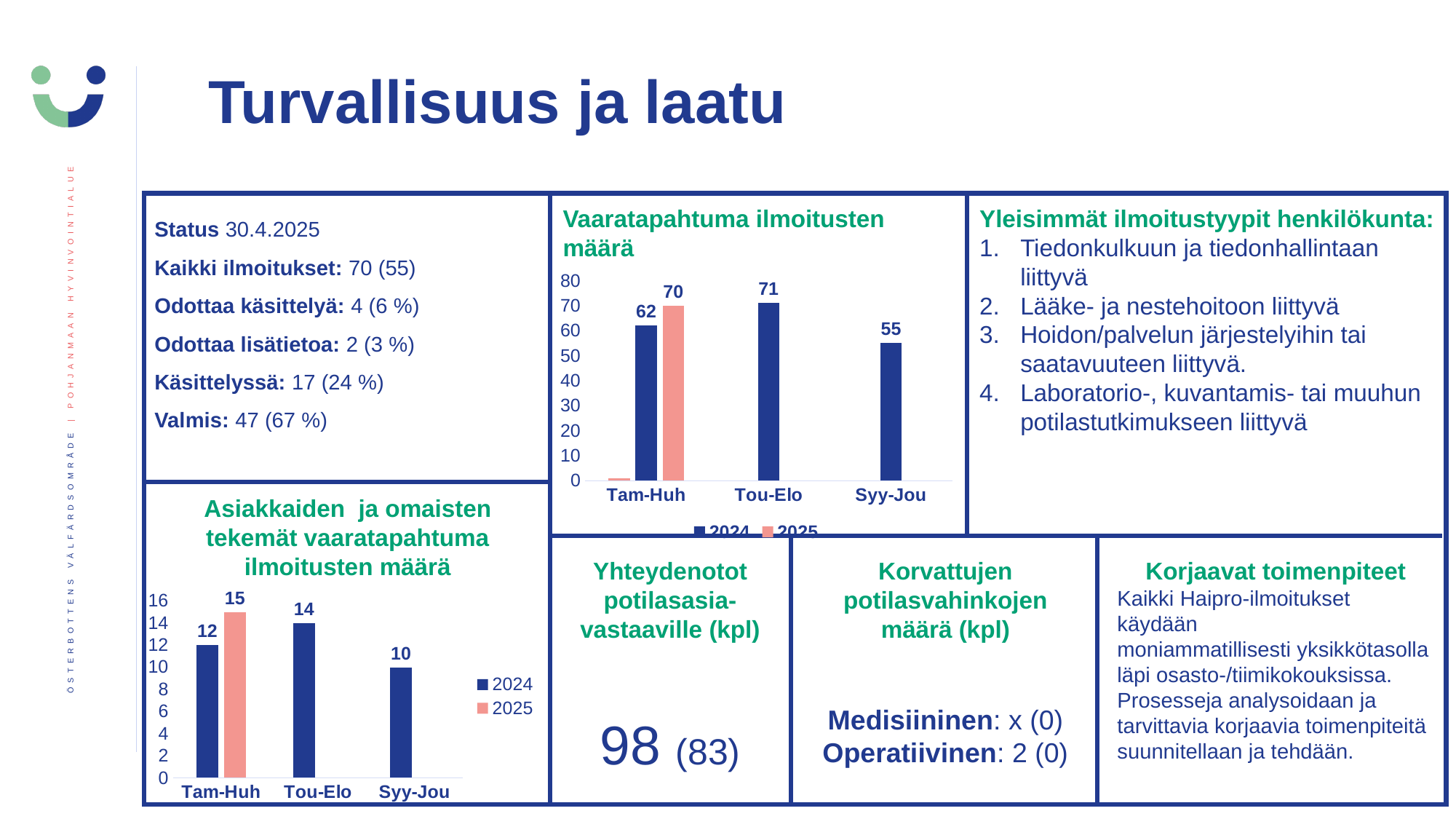
In the chart 'Asiakkaiden ja omaisten tekemät vaaratapahtuma ilmoitusten määrä', how many categories are shown on the x axis? 3 What type of chart is 'Asiakkaiden ja omaisten tekemät vaaratapahtuma ilmoitusten määrä'? bar chart In the chart 'Vaaratapahtuma ilmoitusten määrä', what is the 2024 value for Tou-Elo? 71 In the chart 'Vaaratapahtuma ilmoitusten määrä', which category has the lowest 2024 value? Syy-Jou In the chart 'Asiakkaiden ja omaisten tekemät vaaratapahtuma ilmoitusten määrä', what is the 2025 value for Tam-Huh? 15 In the chart 'Vaaratapahtuma ilmoitusten määrä', how many series does the legend list? 2 In the chart 'Asiakkaiden ja omaisten tekemät vaaratapahtuma ilmoitusten määrä', what is the 2024 value for Syy-Jou? 10 In the chart 'Vaaratapahtuma ilmoitusten määrä', what is the difference between the 2025 and 2024 values for Tam-Huh? 8 In the chart 'Asiakkaiden ja omaisten tekemät vaaratapahtuma ilmoitusten määrä', which is larger for Tam-Huh: the 2024 value or the 2025 value? 2025 In the chart 'Vaaratapahtuma ilmoitusten määrä', what is the 2025 value for Tam-Huh? 70 In the chart 'Vaaratapahtuma ilmoitusten määrä', is the 2024 value for Tou-Elo greater or less than 60? greater In the chart 'Asiakkaiden ja omaisten tekemät vaaratapahtuma ilmoitusten määrä', which category has the highest 2024 value? Tou-Elo